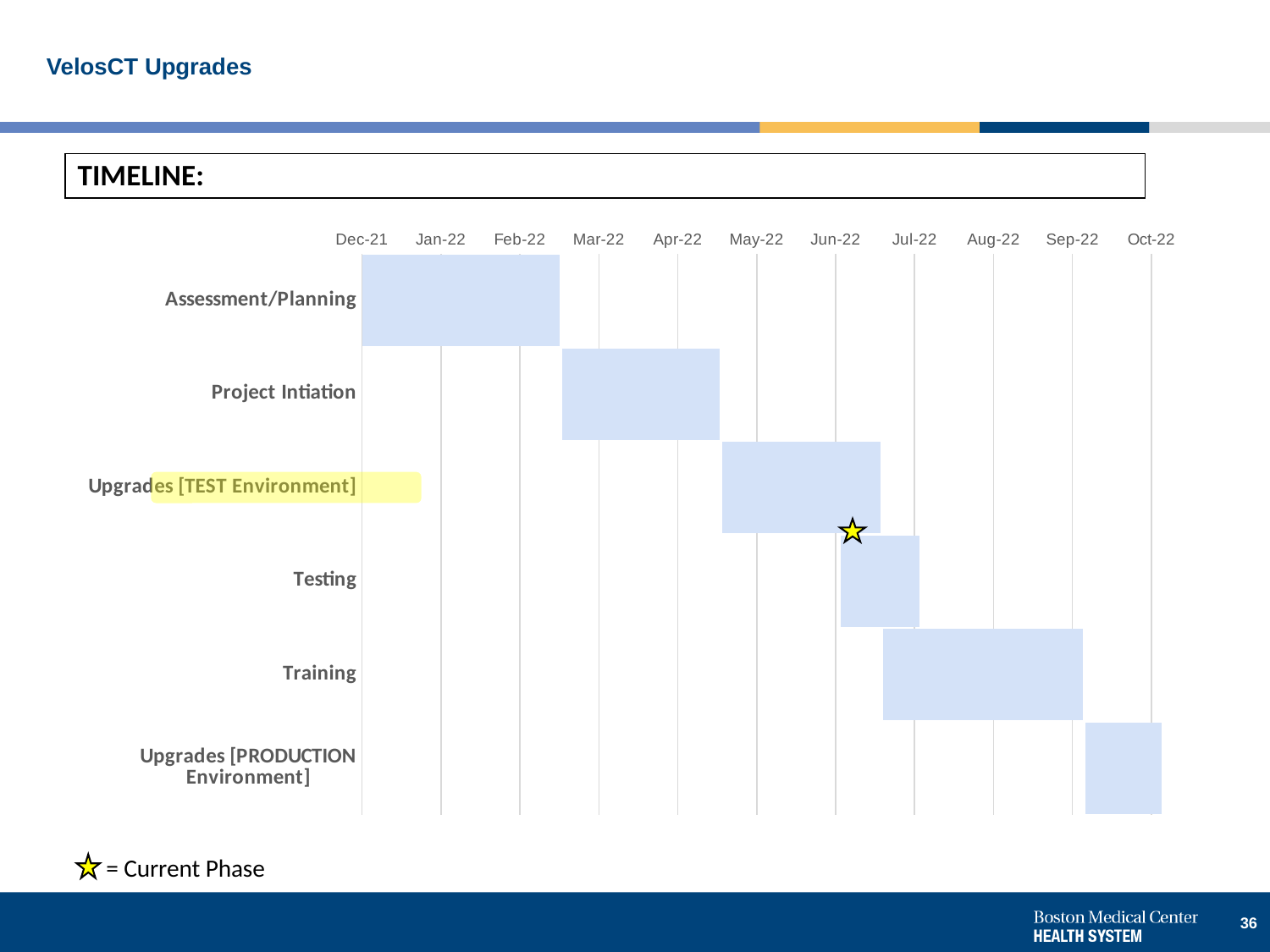
Which phase starts earlier, Project Intiation or Testing? Project Intiation Reading down the list of phases, do the bars move later or earlier in time? later What kind of chart is shown on the slide? Bar chart (Gantt timeline) Does the Training bar end before or after Aug-22? after Which phase lasts longer, Training or Testing? Training What is the first month label on the horizontal axis? Dec-21 According to the legend note, what does the star symbol indicate? Current Phase Which phase ends latest on the timeline? Upgrades [PRODUCTION Environment] Which phase starts earliest on the timeline? Assessment/Planning Which phase is marked with the star as the current phase? Upgrades [TEST Environment] How many phases are listed on the vertical axis of the timeline chart? 6 Does the Assessment/Planning bar end before or after Mar-22? before